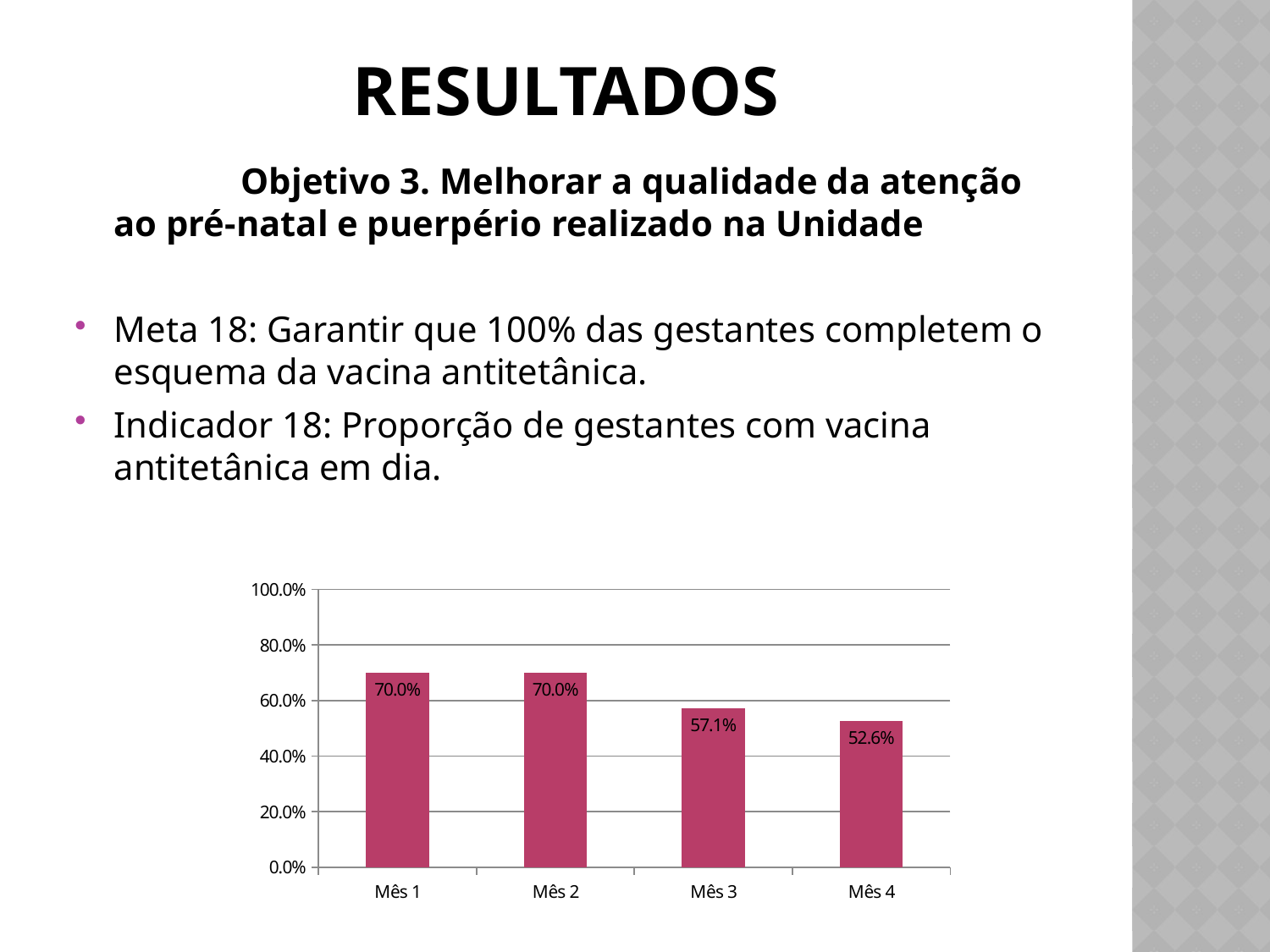
What is the value for Mês 1? 70.0% What is the value for Mês 3? 57.1% What is the difference between the values for Mês 3 and Mês 4? 4.5% How many months are shown on the x axis? 4 What is the value for Mês 4? 52.6% Which month has the lowest value? Mês 4 Which is larger, the value for Mês 3 or the value for Mês 4? Mês 3 Do the values rise or fall from Mês 2 to Mês 4? fall What kind of chart is shown on the slide? bar chart What is the highest value shown on the y axis? 100.0% Is the value for Mês 4 greater or less than 60.0%? less What is the difference between the values for Mês 2 and Mês 4? 17.4%